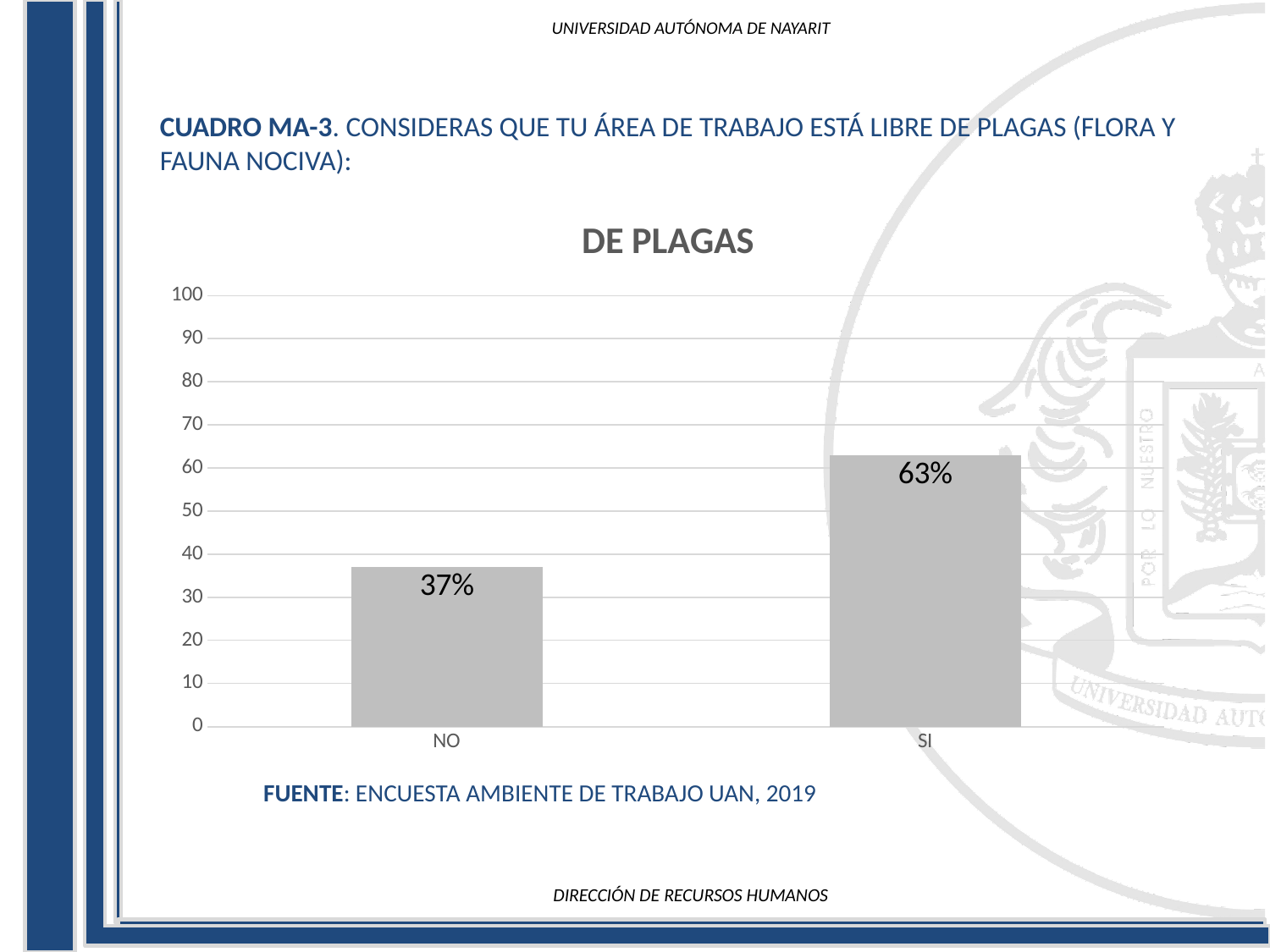
What is the title of the chart? DE PLAGAS What is the difference between the values for SI and NO? 26% Is the value for NO greater or less than 40? less What kind of chart is shown on the slide? bar chart Is the value for SI greater or less than 50? greater What is the value for NO? 37% Which is larger, the value for NO or the value for SI? SI What is the value for SI? 63% Which category has the highest value? SI Which category has the lowest value? NO What is the maximum value shown on the vertical axis? 100 How many categories are shown on the x axis? 2